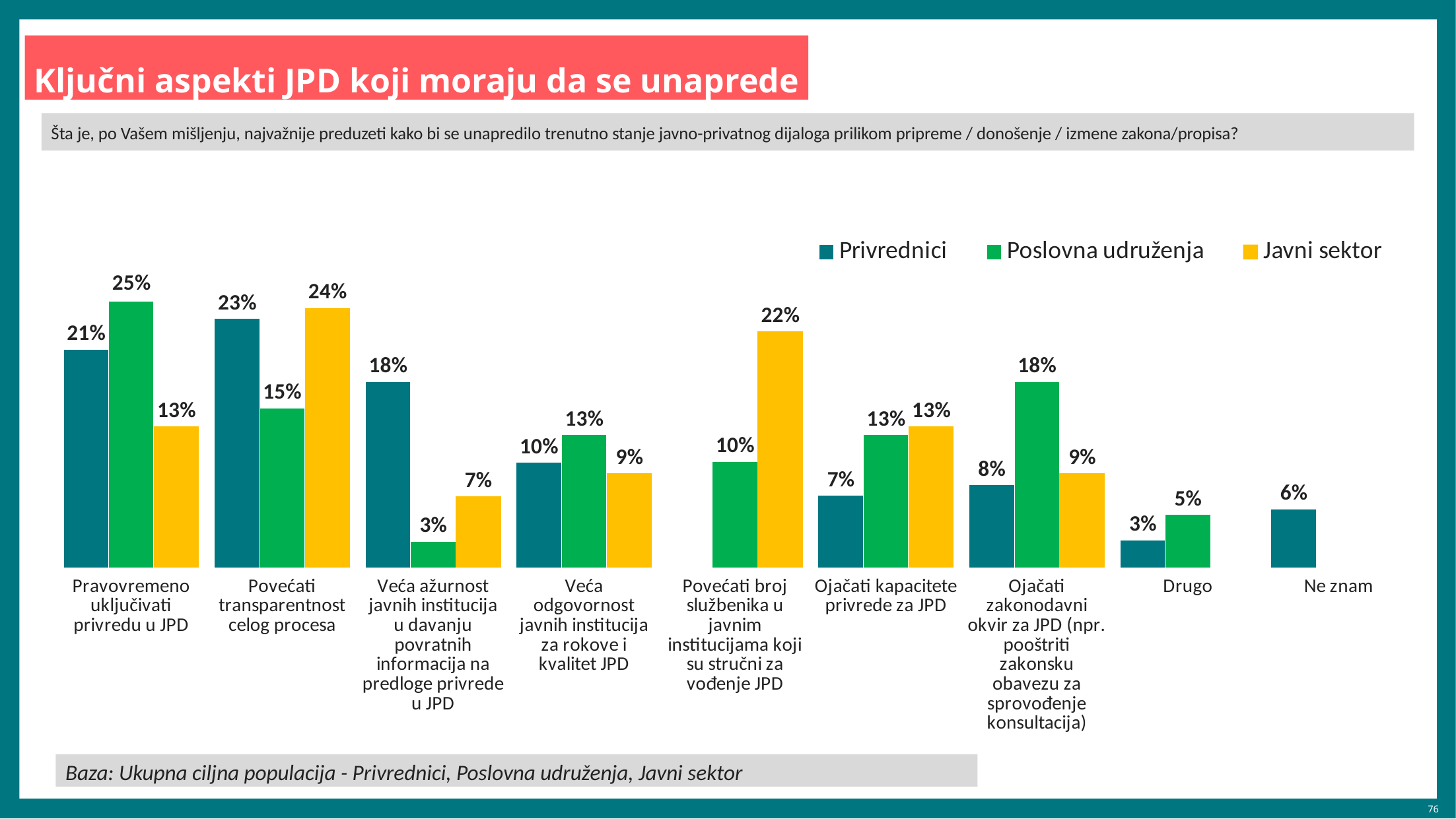
How many series does the legend list? 3 Which legend entry is shown in yellow? Javni sektor Which series has the highest value in the category 'Pravovremeno uključivati privredu u JPD'? Poslovna udruženja In the category 'Veća odgovornost javnih institucija za rokove i kvalitet JPD', which is larger: the Privrednici value or the Poslovna udruženja value? Poslovna udruženja What is the value for Privrednici in the category 'Pravovremeno uključivati privredu u JPD'? 21% Which series has the lowest value in the category 'Ojačati zakonodavni okvir za JPD'? Privrednici What is the value for Poslovna udruženja in the category 'Veća ažurnost javnih institucija u davanju povratnih informacija na predloge privrede u JPD'? 3% What is the value for Javni sektor in the category 'Povećati transparentnost celog procesa'? 24% What is the value for Privrednici in the category 'Ne znam'? 6% What is the difference between the Poslovna udruženja and Privrednici values in the category 'Ojačati zakonodavni okvir za JPD'? 10% What type of chart is shown on the slide? bar chart What is the value for Javni sektor in the category 'Povećati broj službenika u javnim institucijama koji su stručni za vođenje JPD'? 22%